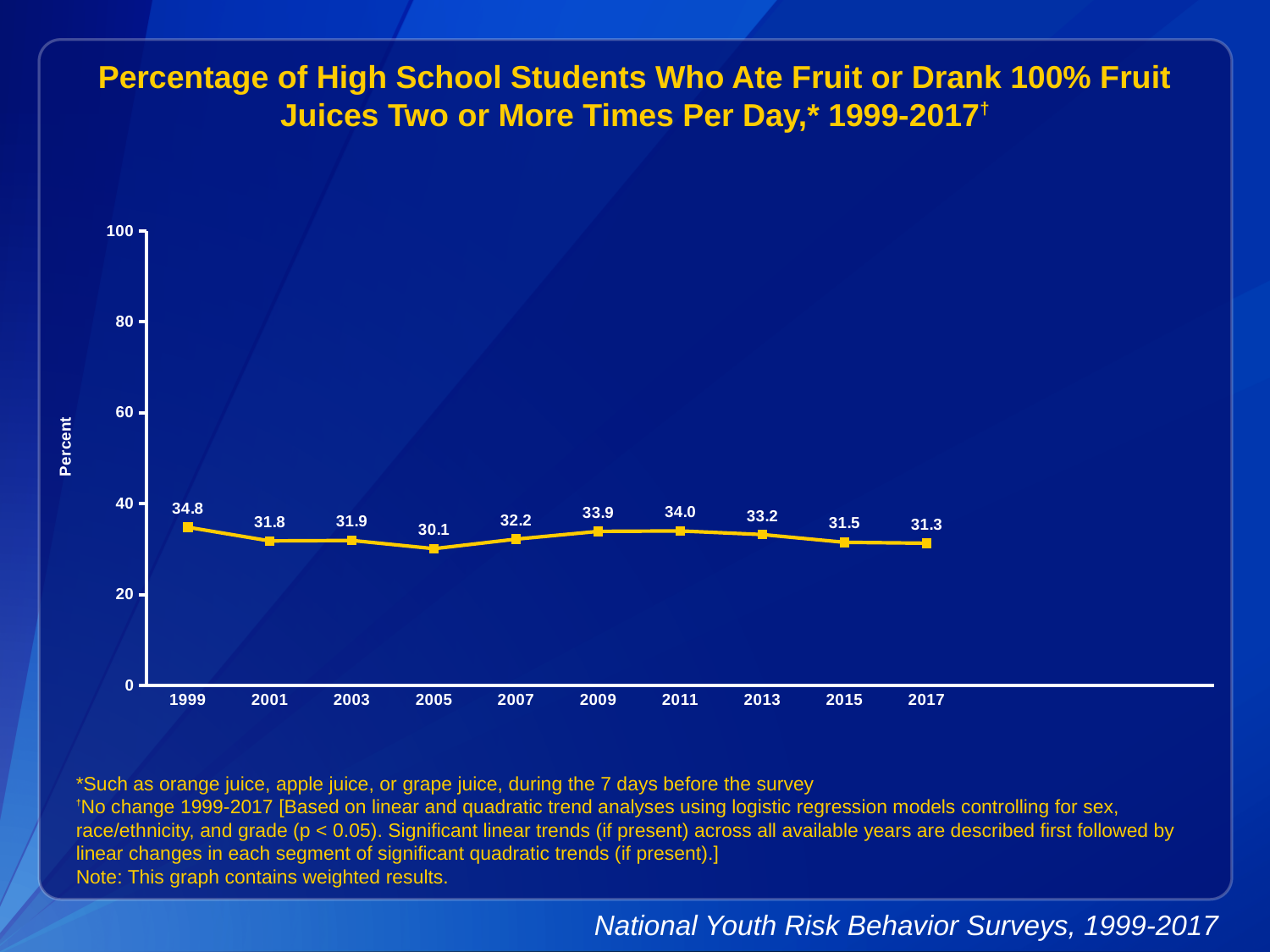
How many years are plotted on the chart? 10 What value is shown for 2005? 30.1 Which year has the lowest percentage? 2005 Which year has the highest percentage? 1999 What is the label on the y axis? Percent What was the percentage of high school students who ate fruit or drank 100% fruit juices two or more times per day in 1999? 34.8 What value is shown for 2017? 31.3 Which is larger, the value for 2009 or the value for 2013? 2009 What value is shown for 2011? 34.0 Is the value for 2007 greater or less than 40? less What kind of chart is shown on the slide? line chart What is the difference between the 1999 value and the 2017 value? 3.5